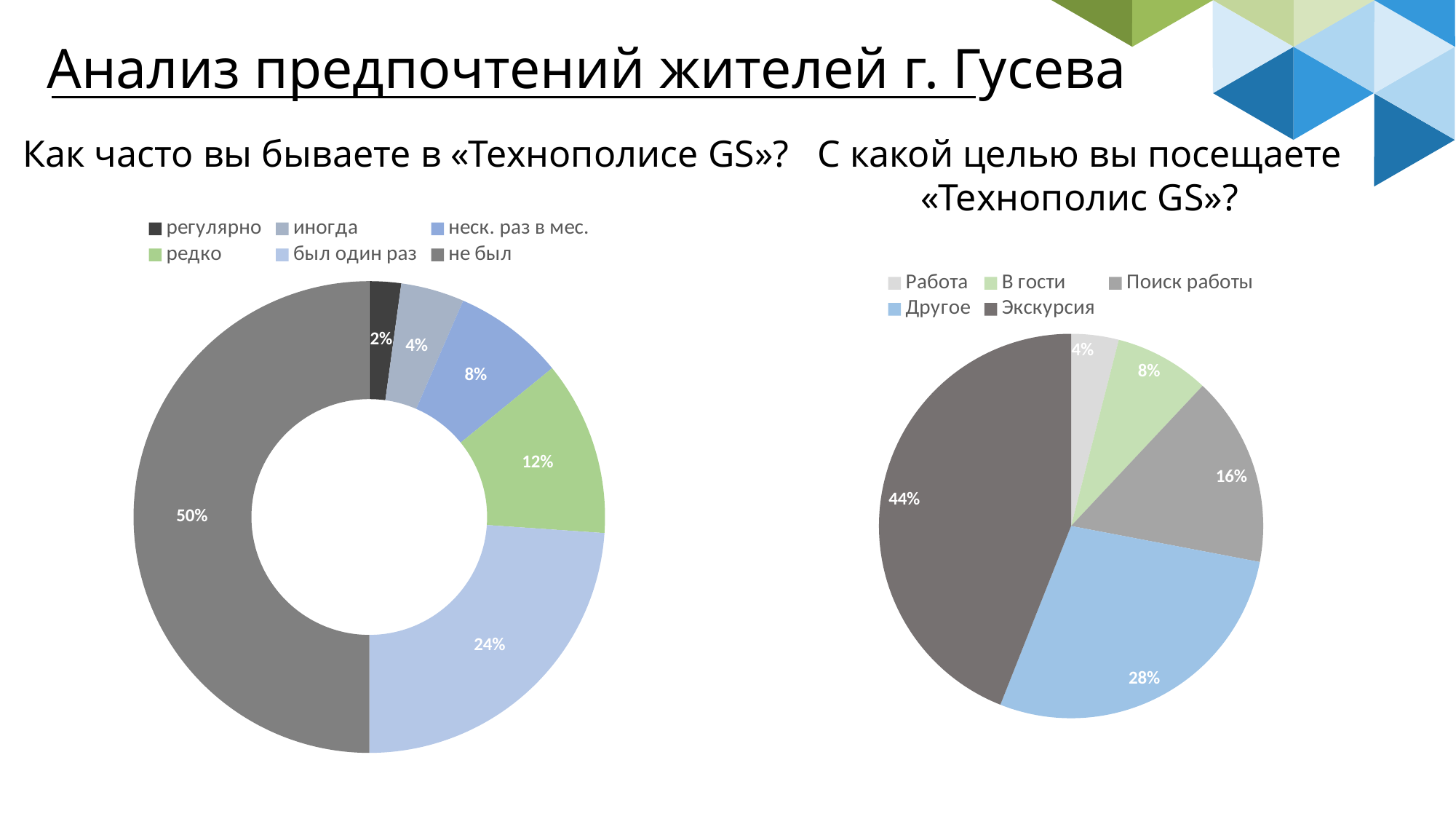
In the chart «Как часто вы бываете в «Технополисе GS»?», what is the difference between the shares for «был один раз» and «неск. раз в мес.»? 16% In the chart «С какой целью вы посещаете «Технополис GS»?», which category has the largest share? Экскурсия In the chart «С какой целью вы посещаете «Технополис GS»?», what is the difference between the shares for «Экскурсия» and «Другое»? 16% What kind of chart is the left chart, «Как часто вы бываете в «Технополисе GS»?»? Donut (pie) chart In the chart «С какой целью вы посещаете «Технополис GS»?», what share of respondents chose «Экскурсия»? 44% In the chart «Как часто вы бываете в «Технополисе GS»?», how many categories does the legend list? 6 In the chart «С какой целью вы посещаете «Технополис GS»?», how many categories does the legend list? 5 In the chart «Как часто вы бываете в «Технополисе GS»?», what share of respondents answered «редко»? 12% In the chart «Как часто вы бываете в «Технополисе GS»?», which category has the smallest share? регулярно In the chart «С какой целью вы посещаете «Технополис GS»?», what share of respondents chose «Поиск работы»? 16% In the chart «С какой целью вы посещаете «Технополис GS»?», which is larger: «Другое» or «В гости»? Другое In the chart «Как часто вы бываете в «Технополисе GS»?», what share of respondents answered «не был»? 50%